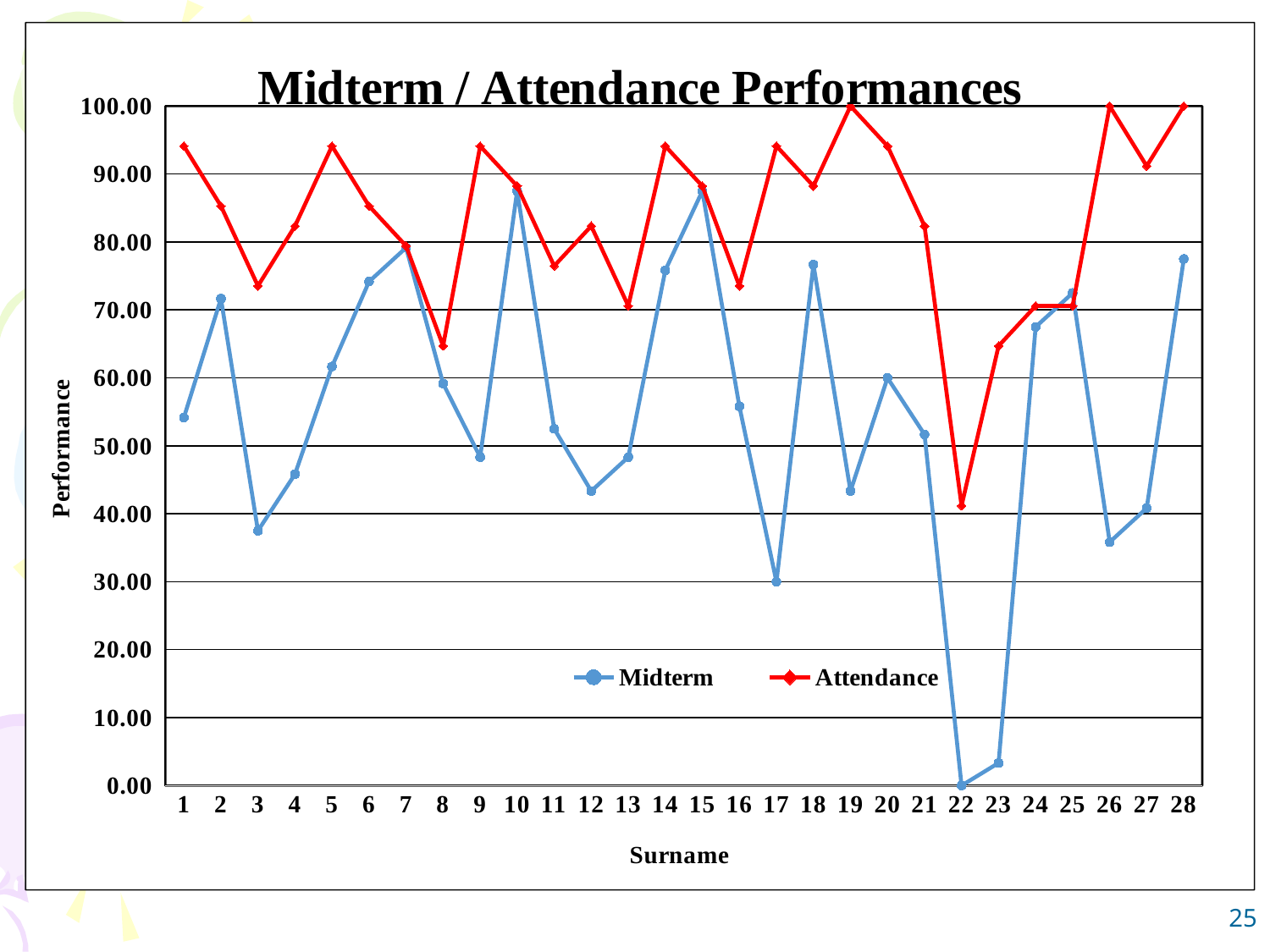
For category 17, which is larger, the Midterm value or the Attendance value? Attendance Which category has the lowest Midterm value? 22 Is the Attendance value for category 8 greater or less than 70? less Is the Midterm value for category 17 greater or less than 40? less Is the Attendance value for category 22 greater or less than 50? less What kind of chart is shown on the slide? line chart Which series is drawn in red? Attendance How many categories are plotted along the x axis? 28 What is the title of the chart? Midterm / Attendance Performances How many series does the legend list? 2 Which category has the lowest Attendance value? 22